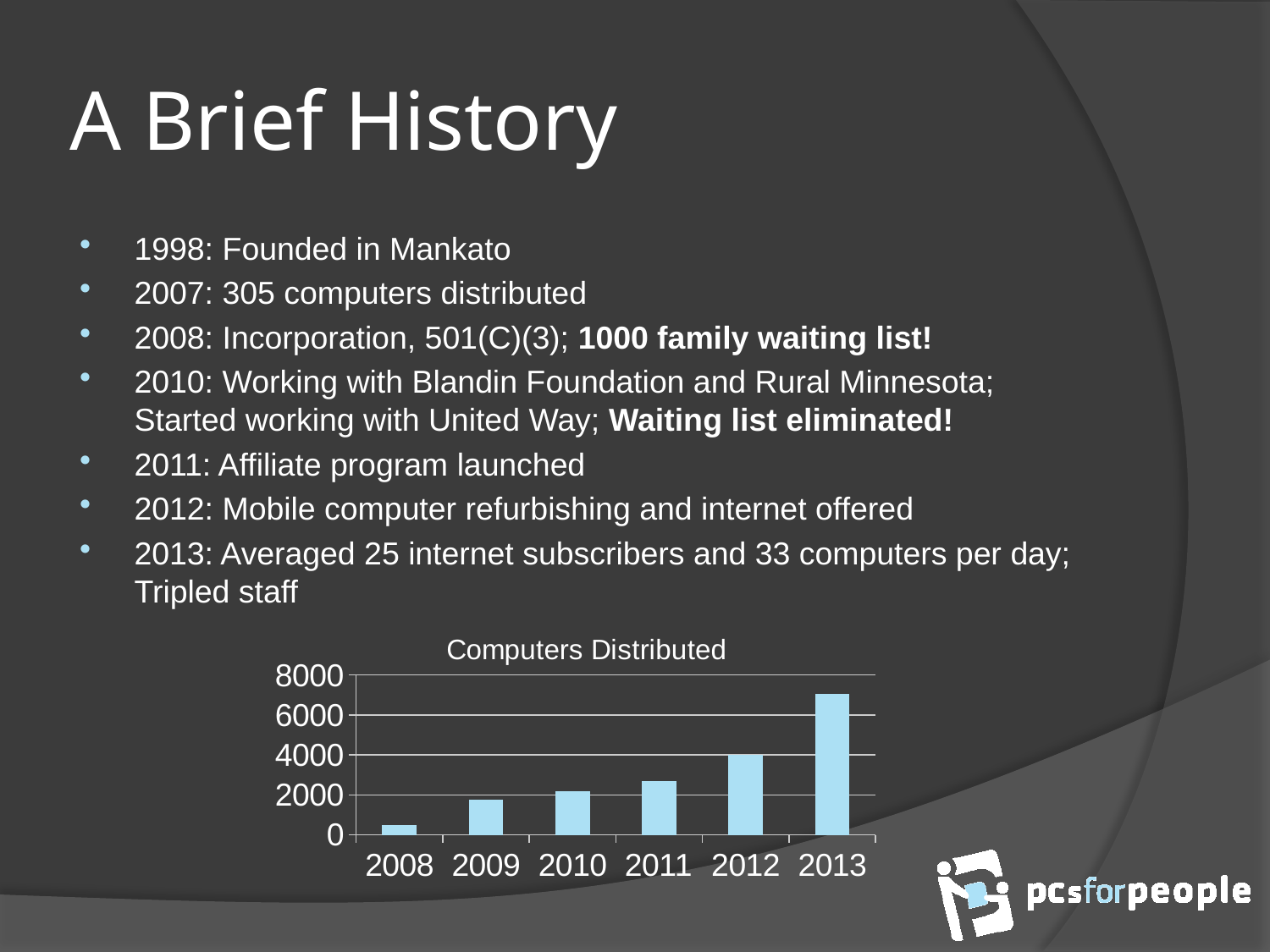
Which is larger, the value for 2012 or the value for 2011? 2012 Which year has the lowest number of computers distributed? 2008 Do the values rise or fall from 2008 to 2013? rise What kind of chart is shown on the slide? bar chart Is the value for 2008 greater or less than 2000? less Is the value for 2011 greater or less than 2000? greater Is the value for 2009 greater or less than 2000? less How many years are shown on the x axis of the chart? 6 What is the title of the chart? Computers Distributed Which is larger, the value for 2013 or the value for 2012? 2013 Which year has the highest number of computers distributed? 2013